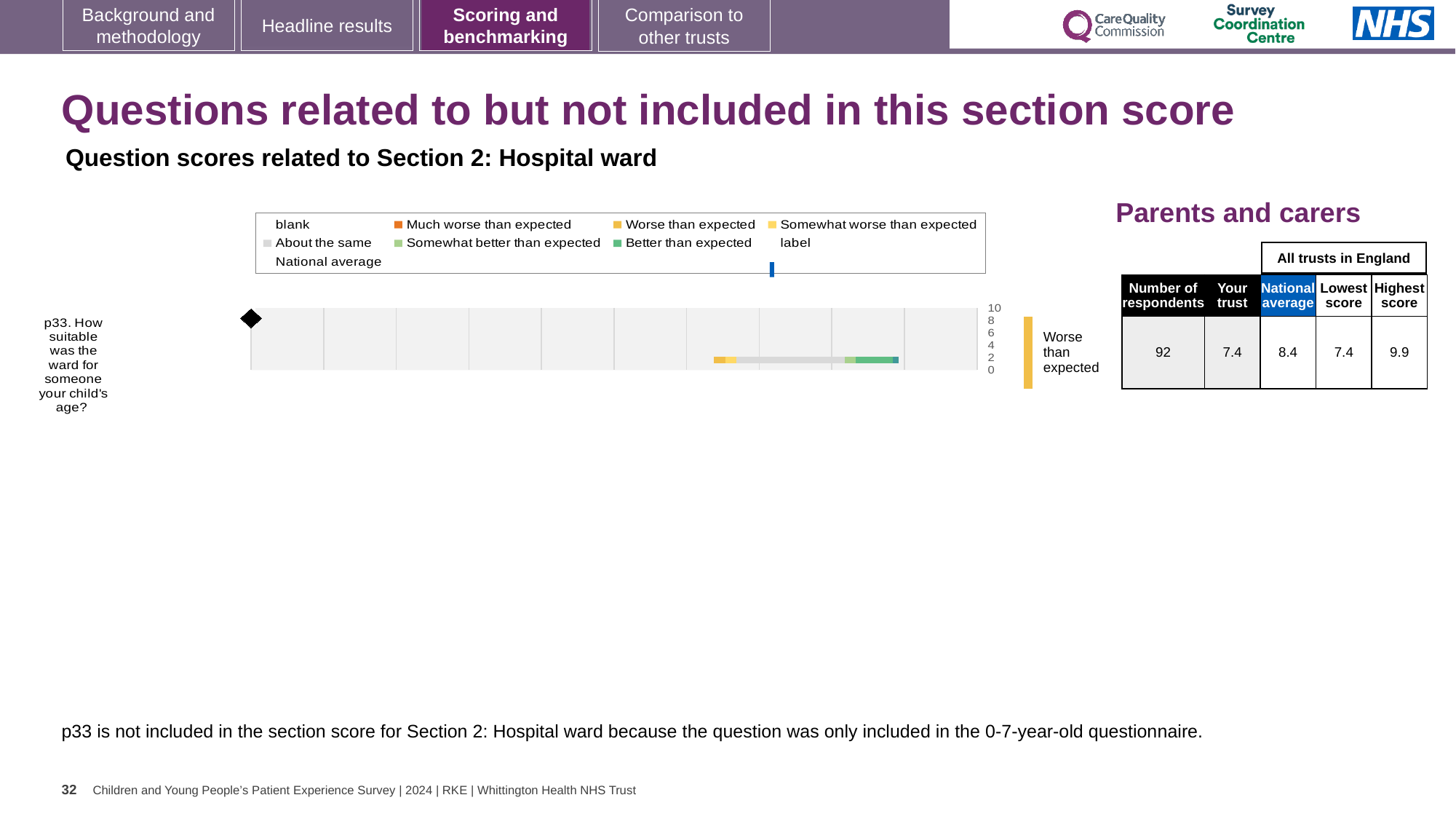
In the table next to the chart, what is the 'Your trust' score for p33? 7.4 In the table next to the chart, what is the national average score for p33? 8.4 In the table next to the chart, what is the number of respondents for p33? 92 What rating label is shown to the right of the chart for p33? Worse than expected Which is larger for p33: the 'Your trust' score or the national average? National average In the table next to the chart, what is the lowest score among all trusts in England for p33? 7.4 What is the difference between the national average (8.4) and the 'Your trust' score (7.4) for p33? 1.0 What kind of chart is shown on the slide? bar chart How many questions (categories) are plotted in the chart? 1 What is the difference between the highest score (9.9) and the lowest score (7.4) for p33? 2.5 Which question is plotted in the chart? p33. How suitable was the ward for someone your child's age? In the table next to the chart, what is the highest score among all trusts in England for p33? 9.9